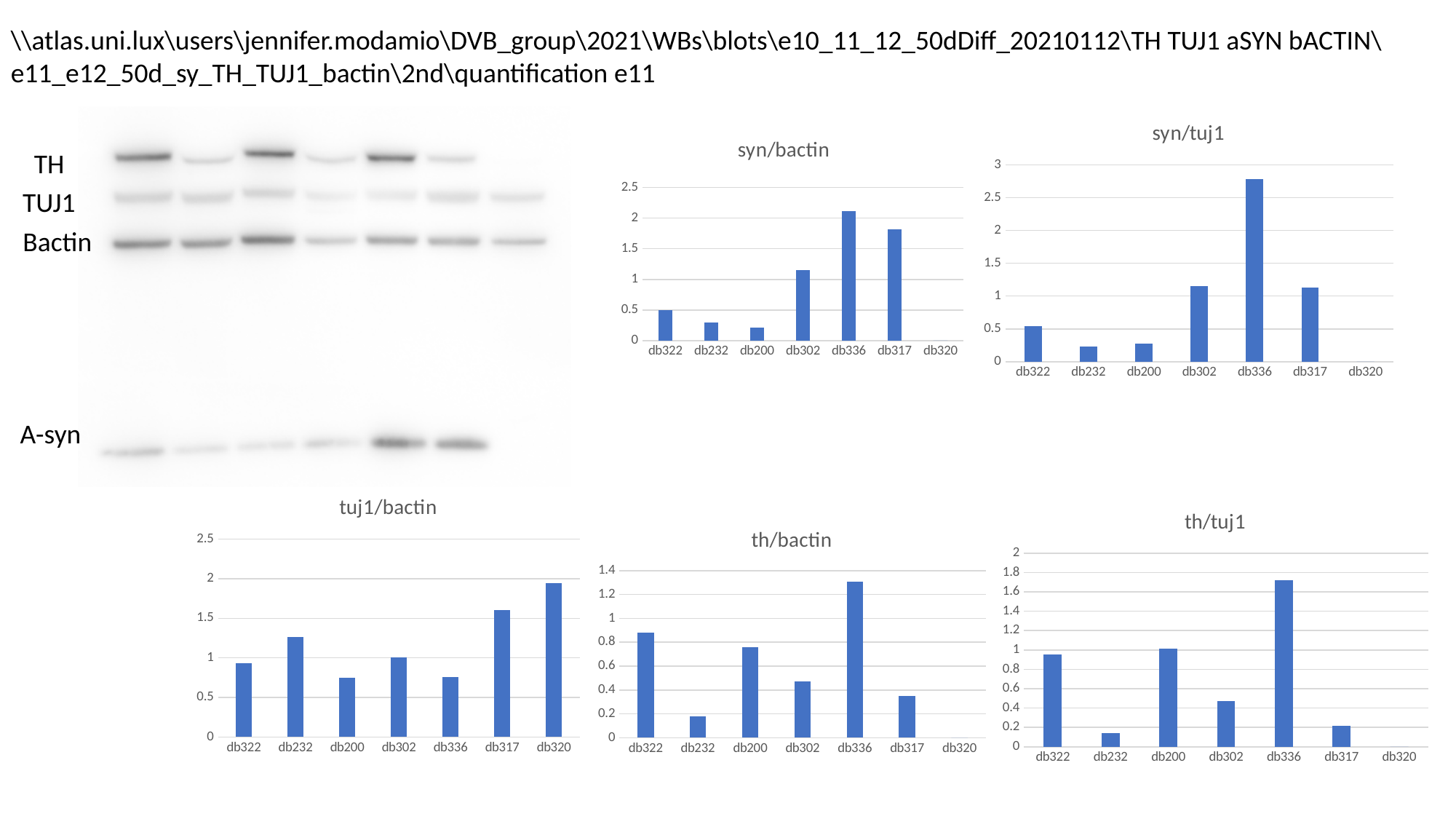
In the th/tuj1 chart, is the value for db336 greater or less than 1.6? greater In the syn/tuj1 chart, which category has the highest value? db336 In the tuj1/bactin chart, which category has the highest value? db320 In the th/bactin chart, which category has the highest value? db336 In the th/bactin chart, which is larger, the value for db322 or the value for db200? db322 How many categories are shown on the x axis of the tuj1/bactin chart? 7 In the syn/bactin chart, which is larger, the value for db336 or the value for db317? db336 In the syn/bactin chart, is the value for db336 greater or less than 2? greater In the syn/tuj1 chart, is the value for db336 greater or less than 2.5? greater What kind of chart is the th/tuj1 chart? bar chart